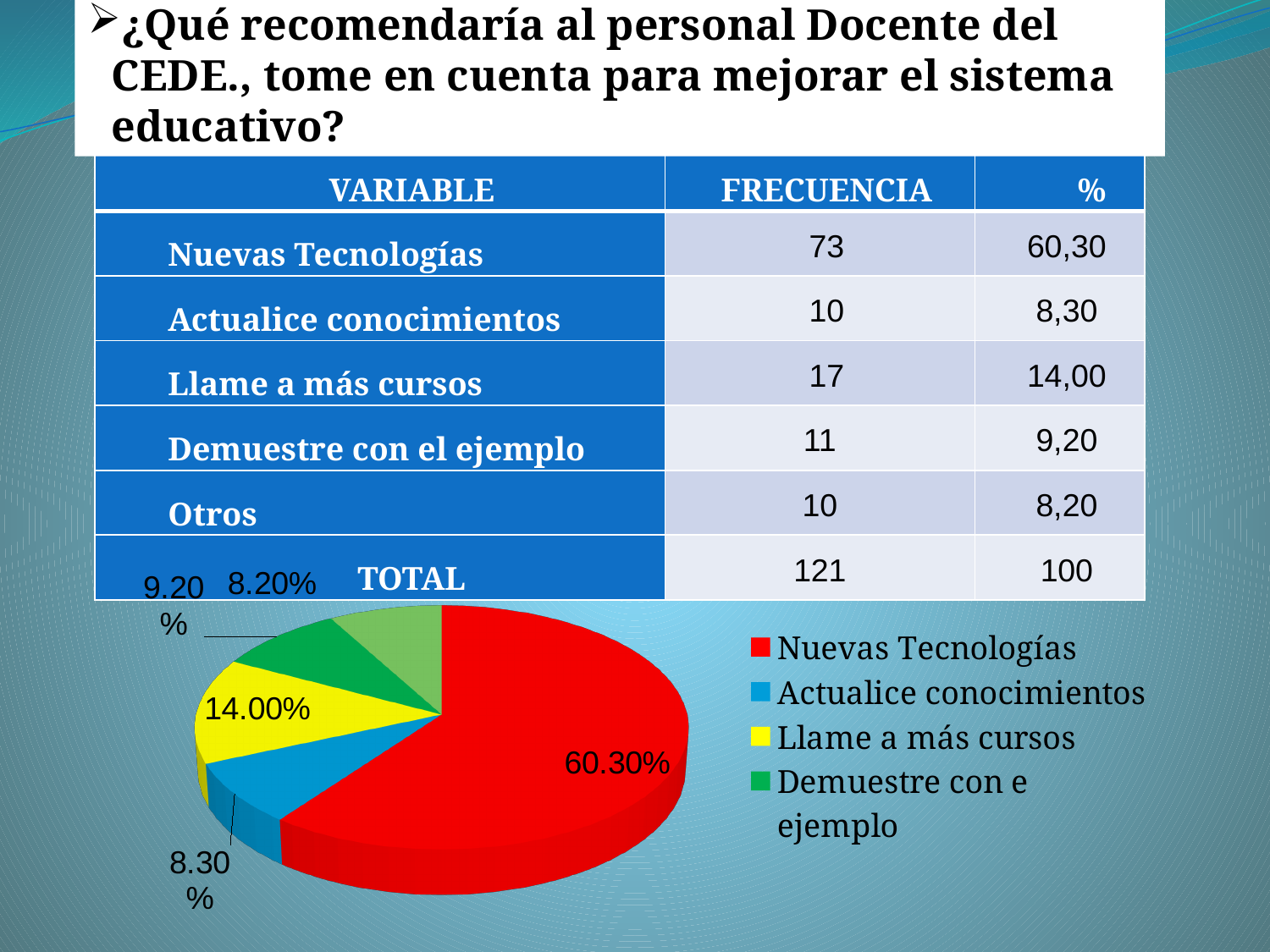
What is the difference in percentage points between the Nuevas Tecnologías slice and the Llame a más cursos slice? 46.30 How many slices does the pie chart have? 5 How many entries are listed in the pie chart's legend? 4 Which slice is larger in the pie chart: Llame a más cursos or Actualice conocimientos? Llame a más cursos In the pie chart, what percentage is shown for Demuestre con el ejemplo? 9.20% In the pie chart, what percentage is shown for Actualice conocimientos? 8.30% Which category has the largest slice in the pie chart? Nuevas Tecnologías What colour is the Nuevas Tecnologías slice in the pie chart? red What colour is the Llame a más cursos slice in the pie chart? yellow In the pie chart, what percentage is shown for Llame a más cursos? 14.00% What kind of chart is shown on the slide? pie chart In the pie chart, what percentage is shown for Nuevas Tecnologías? 60.30%